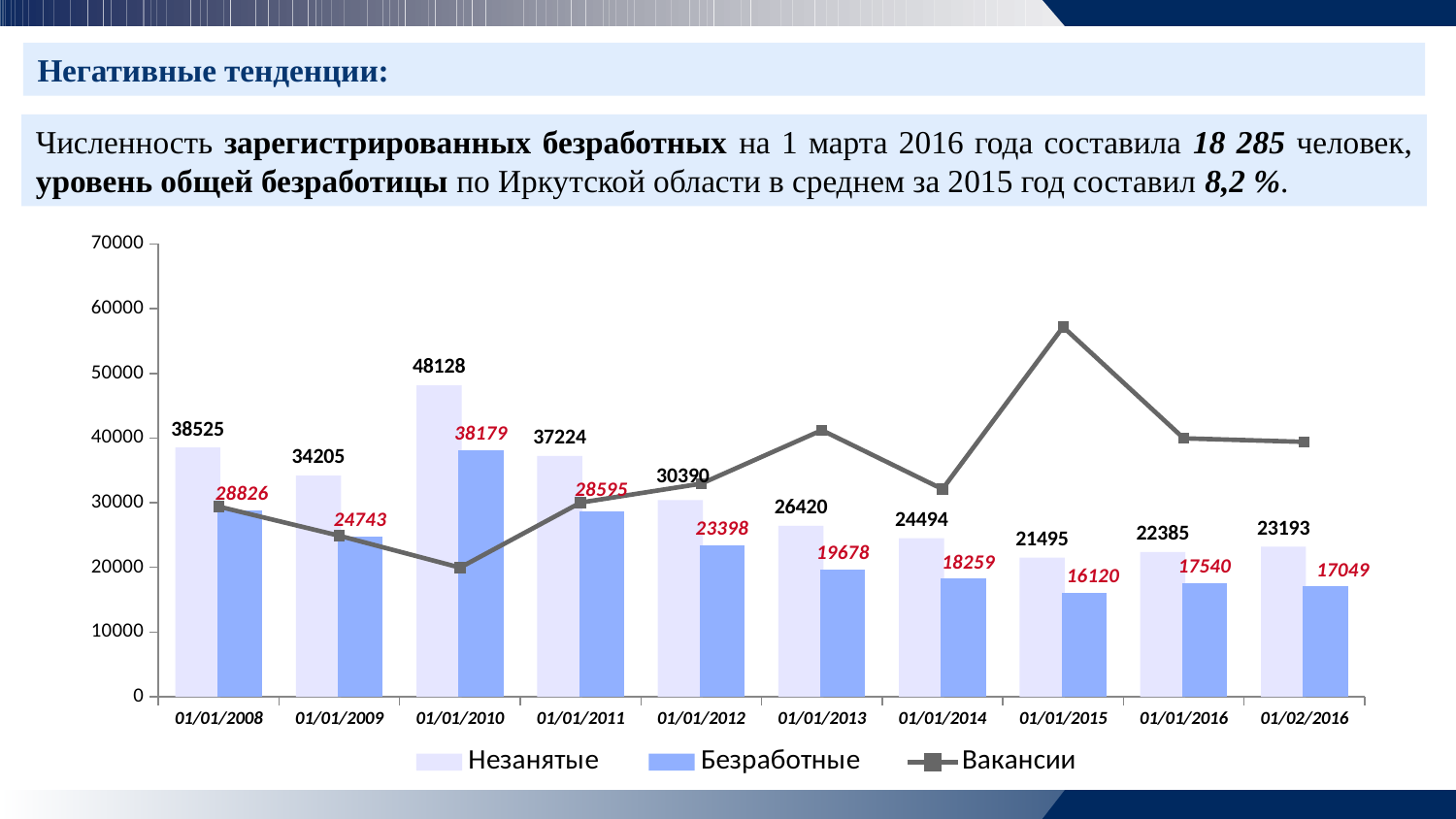
What is the value of Безработные on 01/01/2015? 16120 Is the value for Вакансии on 01/01/2010 greater or less than 30000? less Do the values of Безработные rise or fall from 01/01/2010 to 01/01/2015? fall What kind of chart is shown on the slide? bar and line chart How many dates are shown on the x axis of the chart? 10 How many series does the legend list? 3 What is the difference between Незанятые and Безработные on 01/01/2008? 9699 What is the value of Незанятые on 01/01/2010? 48128 On which date is the value of Незанятые the highest? 01/01/2010 Is the value for Вакансии on 01/01/2015 greater or less than 50000? greater Which date has the larger value of Безработные: 01/01/2016 or 01/02/2016? 01/01/2016 On which date is the value of Безработные the lowest? 01/01/2015